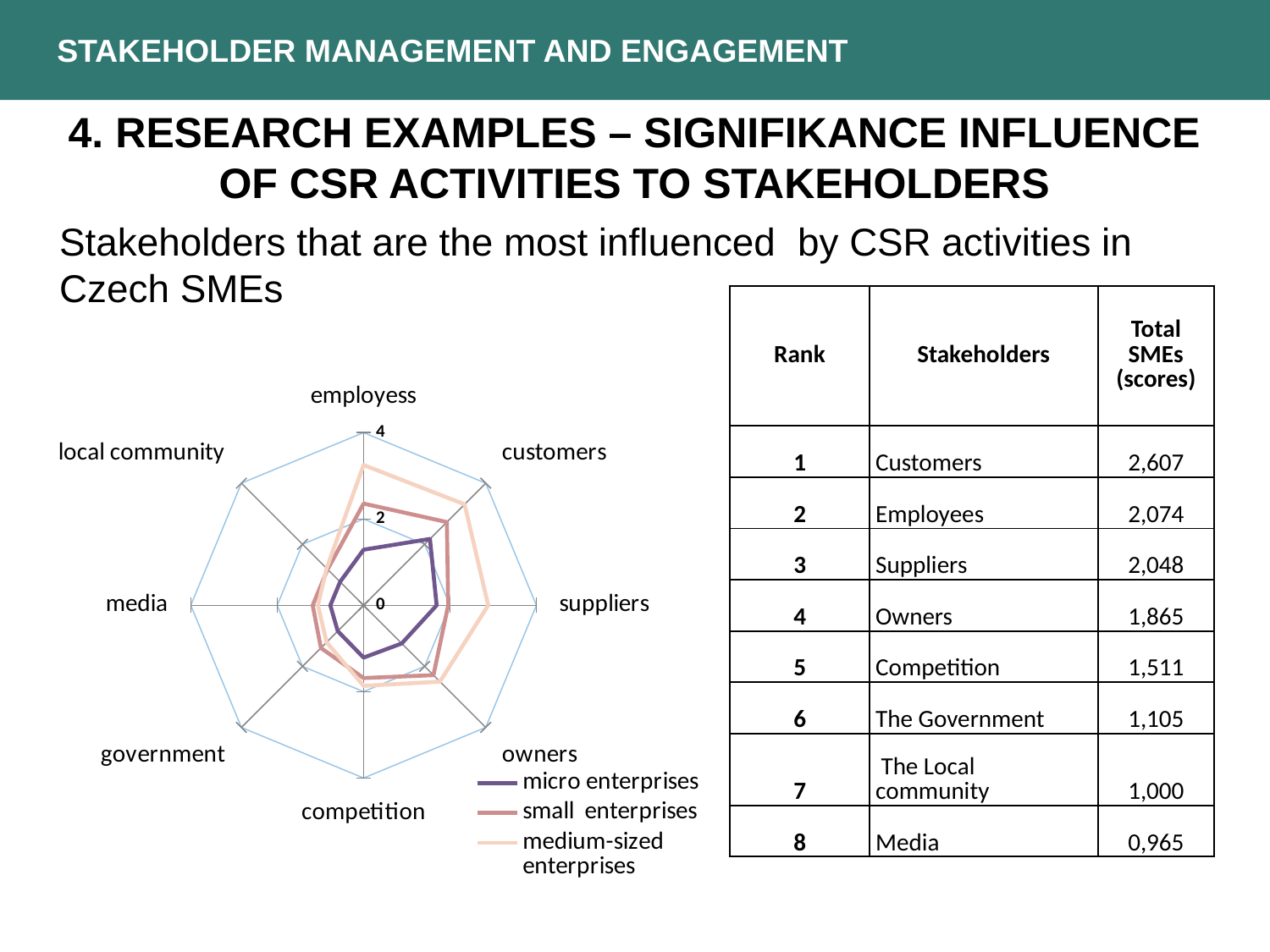
For employess, which series has the larger value: micro enterprises or medium-sized enterprises? medium-sized enterprises What is the highest value shown on the radar chart's axis scale? 4 Is the value for employess for micro enterprises greater or less than 2? less How many stakeholder categories are plotted on the radar chart? 8 Is the value for suppliers for medium-sized enterprises greater or less than 2? greater How many series does the legend of the radar chart list? 3 Is the value for customers for medium-sized enterprises greater or less than 2? greater Which series is drawn in purple on the radar chart? micro enterprises For customers, which series has the larger value: medium-sized enterprises or micro enterprises? medium-sized enterprises What kind of chart is shown on the slide? radar chart